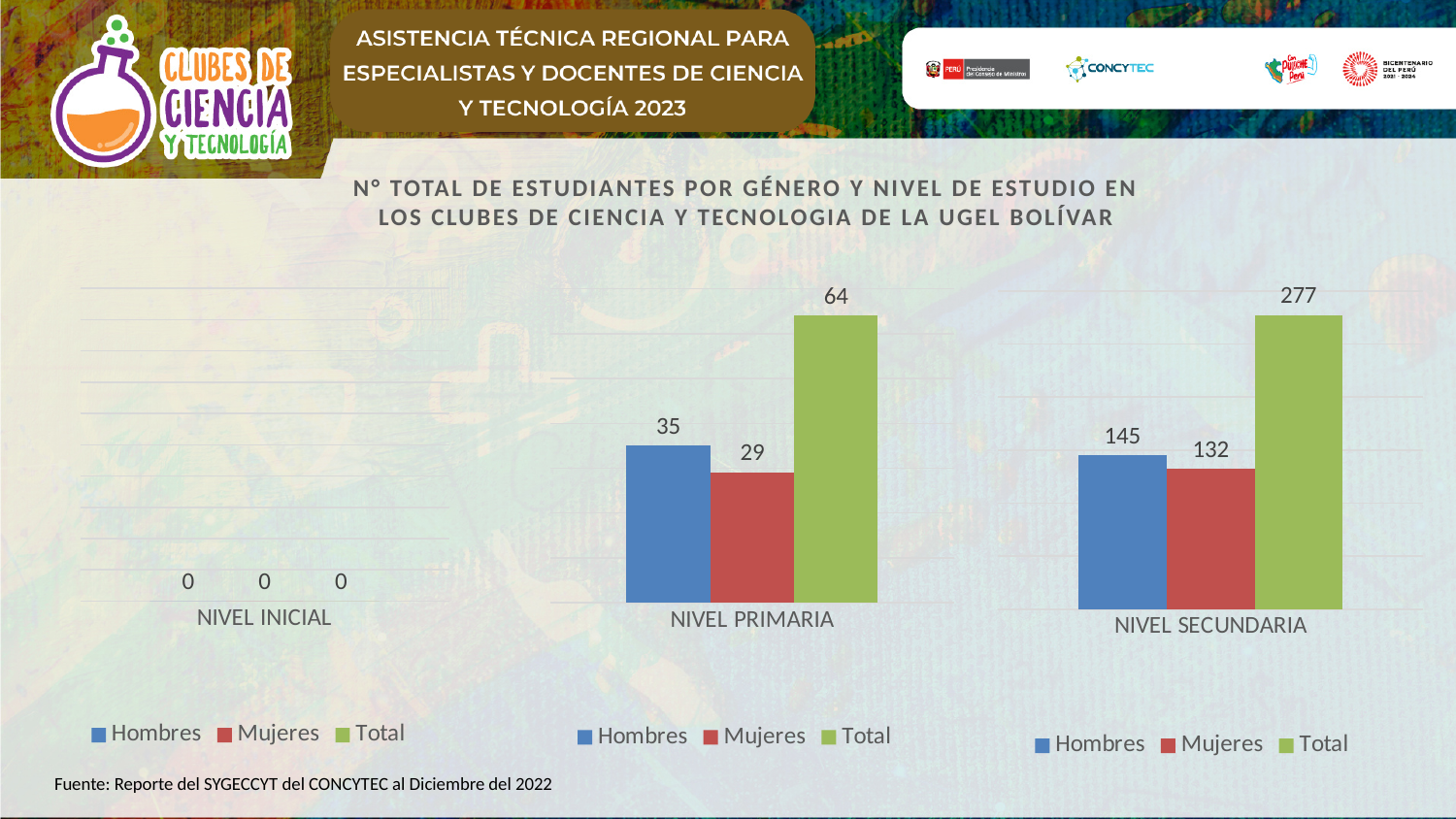
What kind of chart is the right chart (NIVEL SECUNDARIA)? Bar chart In the middle chart (NIVEL PRIMARIA), what is the value for Mujeres? 29 How many series does the legend of the middle chart list? 3 In the left chart (NIVEL INICIAL), what is the value for Hombres? 0 In the middle chart (NIVEL PRIMARIA), what is the value for Hombres? 35 In the right chart (NIVEL SECUNDARIA), what is the value for Mujeres? 132 In the right chart (NIVEL SECUNDARIA), what is the difference between Hombres and Mujeres? 13 In the right chart (NIVEL SECUNDARIA), which series has the highest value? Total In the middle chart (NIVEL PRIMARIA), what is the difference between Total and Hombres? 29 What colour represents Total in the legends of the charts? Green In the right chart (NIVEL SECUNDARIA), what is the value for Total? 277 In the middle chart (NIVEL PRIMARIA), which is larger, Hombres or Mujeres? Hombres